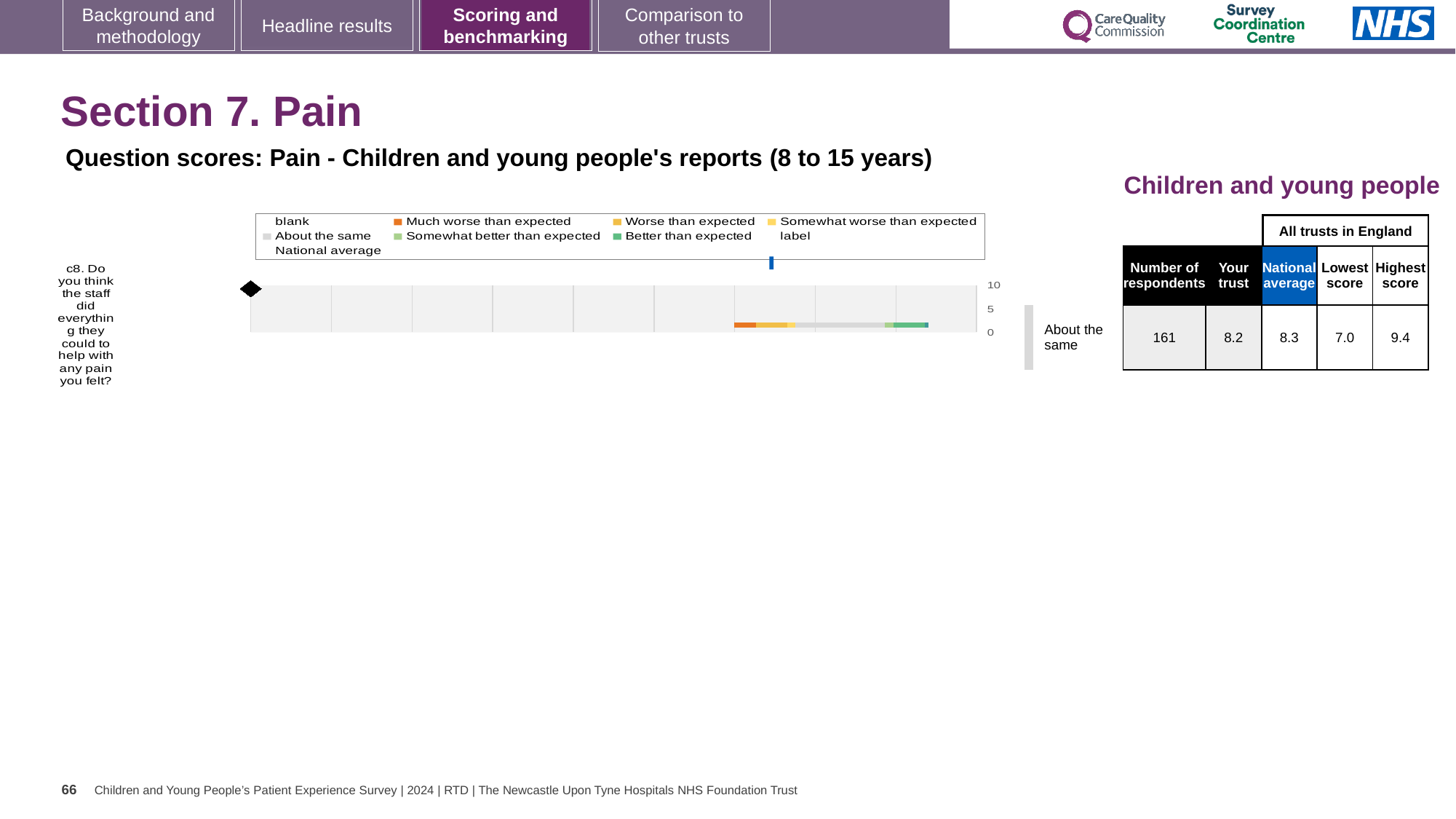
What kind of chart is shown on the slide? bar chart What is the difference between the highest score and the lowest score for question c8? 2.4 How many question categories are plotted in the chart? 1 What is the highest tick value shown on the chart's numeric axis? 10 Which is larger for question c8, the 'Your trust' score or the national average? National average What is the national average score for question c8 shown next to the chart? 8.3 Which legend entry is shown in orange? Much worse than expected What is the 'Your trust' score for question c8 shown next to the chart? 8.2 What is the lowest score among all trusts in England for question c8? 7.0 What benchmark rating is given for question c8 next to the chart? About the same How many respondents answered question c8? 161 What is the highest score among all trusts in England for question c8? 9.4